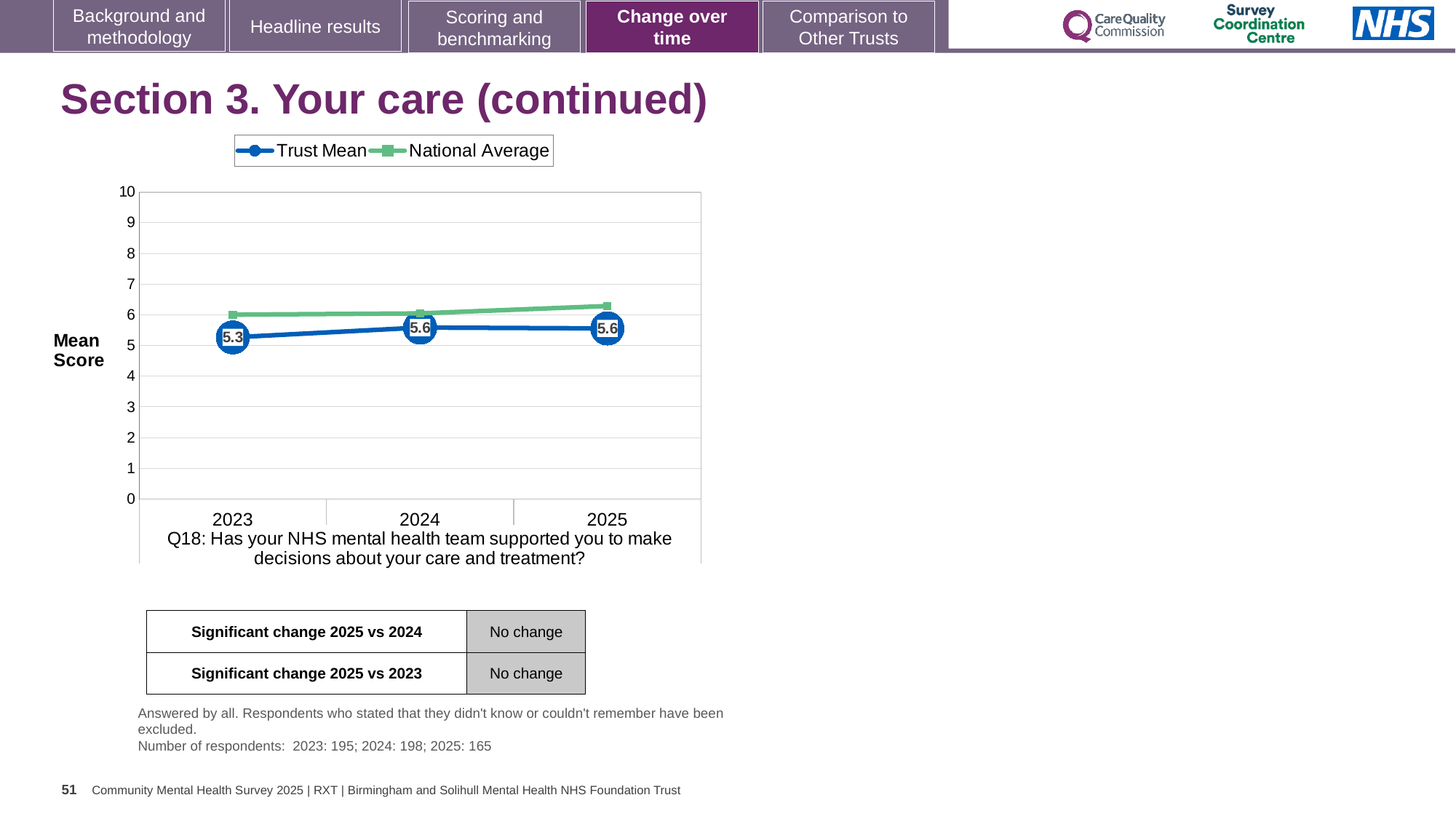
What is the Trust Mean value for 2024? 5.6 In which year is the Trust Mean lowest? 2023 Does the Trust Mean rise or fall from 2023 to 2025? Rise How many years are plotted on the x axis? 3 What kind of chart is shown on the slide? Line chart What is the Trust Mean value for 2025? 5.6 In 2025, which is larger: the Trust Mean or the National Average? National Average What is the label on the y axis of the chart? Mean Score What is the Trust Mean value for 2023? 5.3 Is the National Average value for 2025 greater or less than 6? greater How many series does the legend list? 2 What is the difference between the Trust Mean in 2024 and in 2023? 0.3